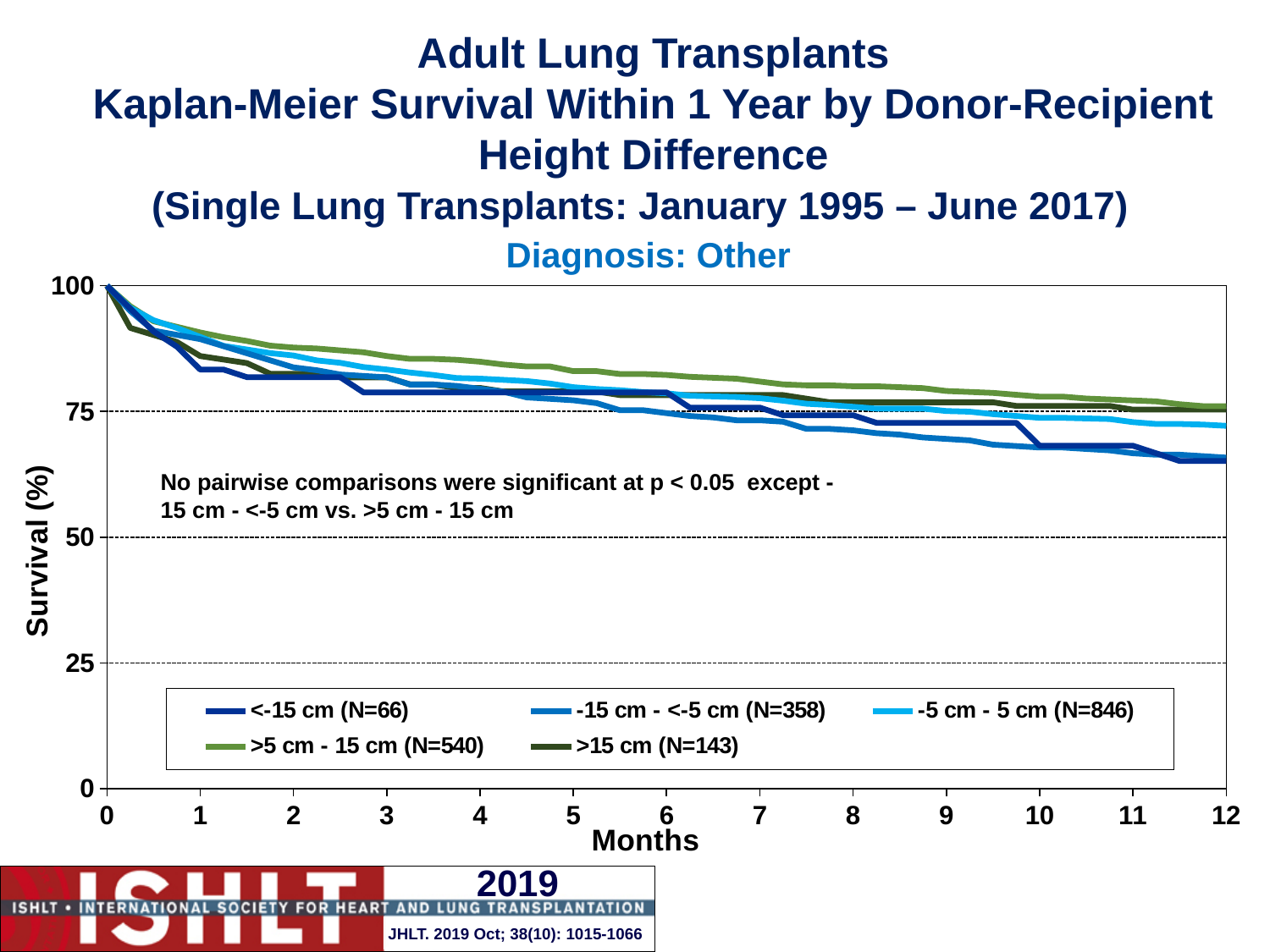
What is the N for the -15 cm - <-5 cm group shown in the legend? 358 Which group has the highest survival at 6 months? >5 cm - 15 cm (N=540) Is the survival value for the >5 cm - 15 cm (N=540) group at 3 months greater or less than 75? greater At 1 month, which group has higher survival: -5 cm - 5 cm (N=846) or <-15 cm (N=66)? -5 cm - 5 cm (N=846) What kind of chart is shown on the slide? Line chart What is the survival value for all groups at 0 months? 100 What is the label of the y axis? Survival (%) Which group has the lowest survival at 1 month? <-15 cm (N=66) Is the survival value for the <-15 cm (N=66) group at 12 months greater or less than 75? less Do the survival curves rise or fall as months increase? Fall How many series does the legend list? 5 Is the survival value for the -5 cm - 5 cm (N=846) group at 12 months greater or less than 50? greater